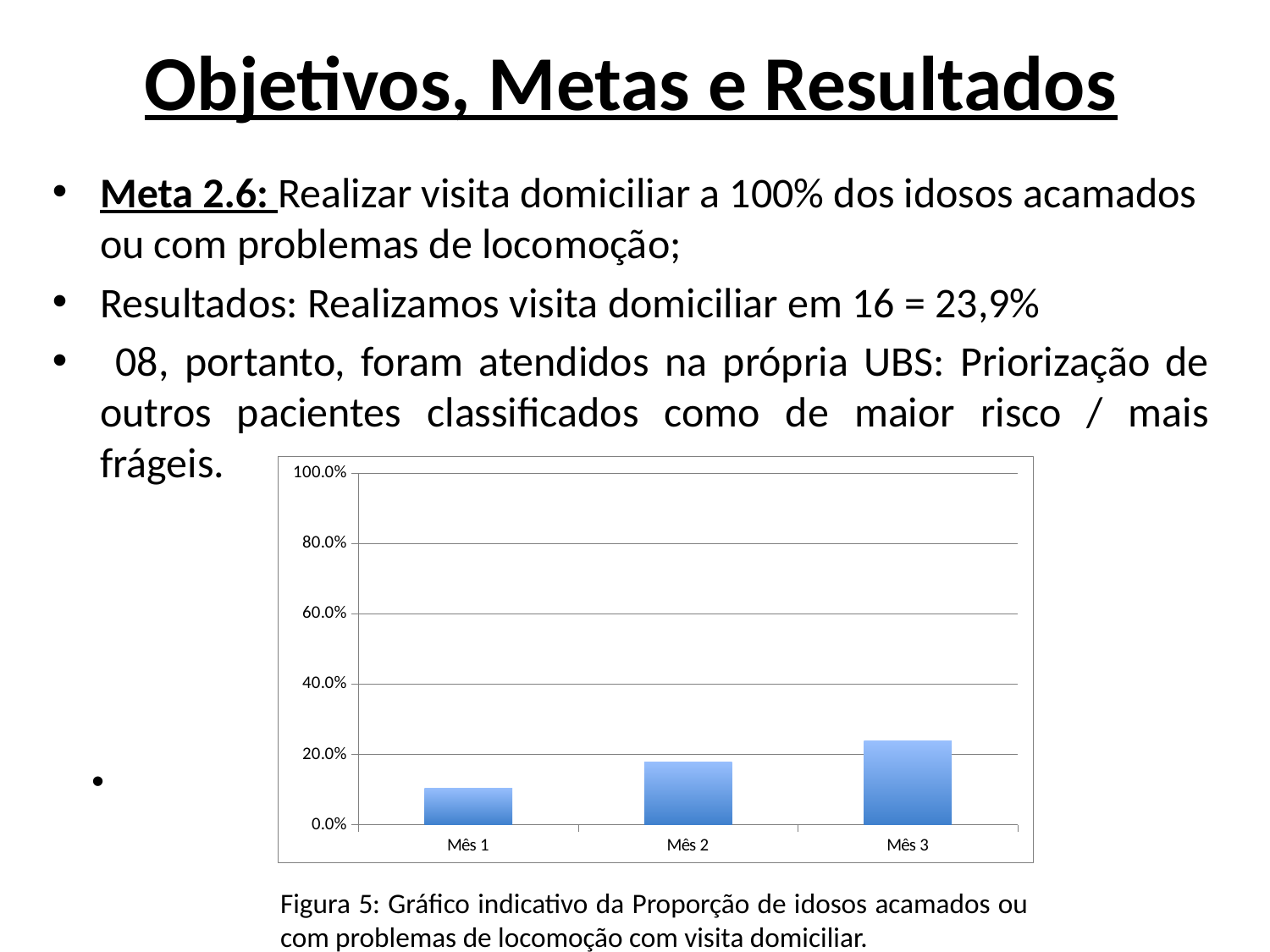
How many categories (months) are shown on the x axis of the chart? 3 Do the values rise or fall from Mês 1 to Mês 3? rise Is the value for Mês 3 greater or less than 40.0%? less Which is larger, the value for Mês 1 or the value for Mês 3? Mês 3 What kind of chart is shown on the slide? bar chart Which is larger, the value for Mês 2 or the value for Mês 1? Mês 2 Which month has the highest bar in the chart? Mês 3 Is the value for Mês 3 greater or less than 20.0%? greater Which month has the lowest bar in the chart? Mês 1 Is the value for Mês 1 greater or less than 20.0%? less What is the highest value shown on the chart's vertical axis? 100.0% What figure number is given in the caption below the chart? Figura 5